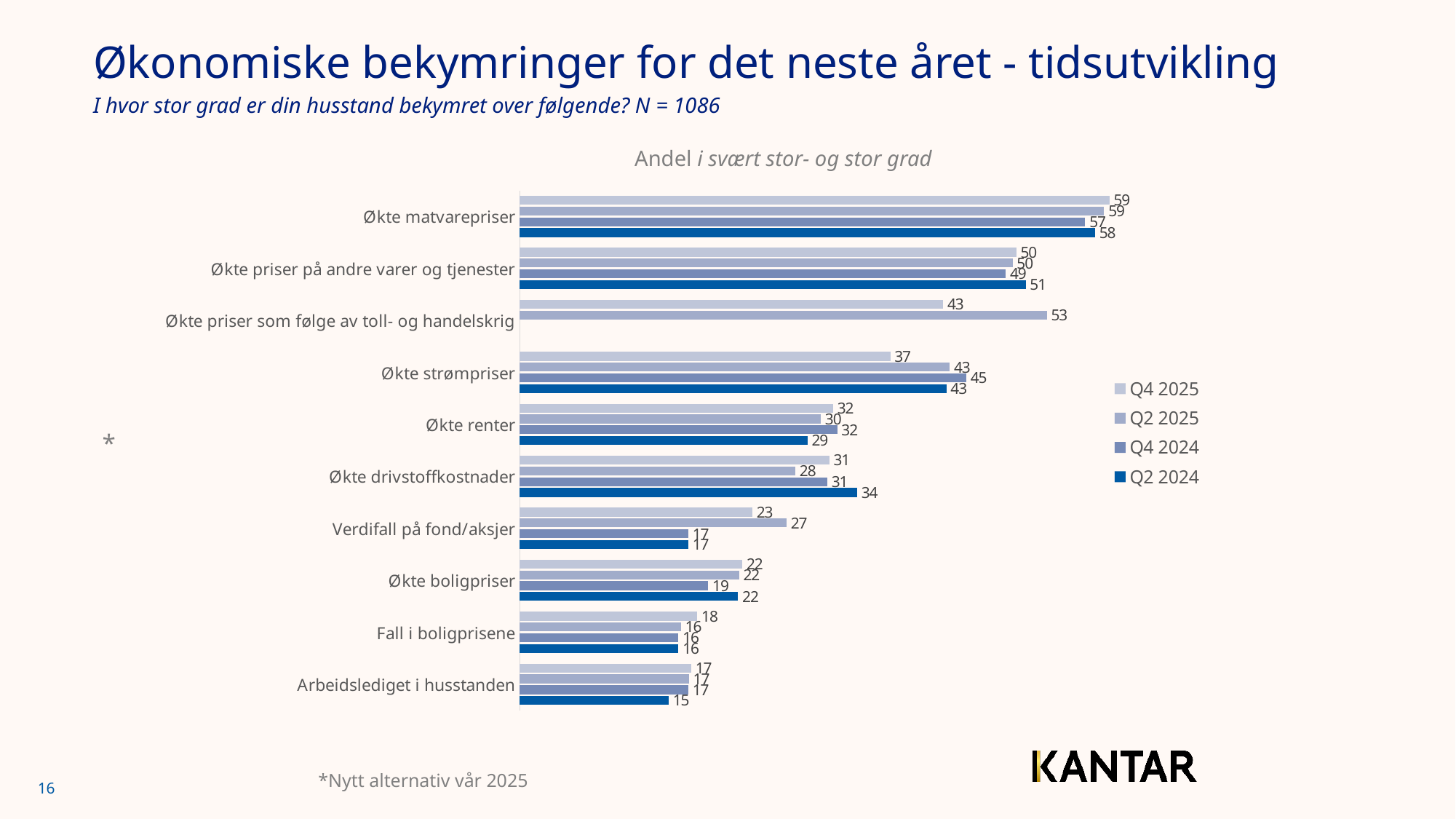
How many series does the legend list? 4 What is the difference between the Q2 2025 and Q4 2024 values for Verdifall på fond/aksjer? 10 Which category has the highest Q4 2025 value? Økte matvarepriser What is the Q4 2025 value for Økte strømpriser? 37 Which series is shown in the darkest blue in the legend? Q2 2024 For Økte renter, which is larger: the Q4 2025 value or the Q2 2024 value? Q4 2025 What kind of chart is shown on the slide? bar chart What is the Q2 2025 value for Økte priser som følge av toll- og handelskrig? 53 What is the Q2 2024 value for Økte drivstoffkostnader? 34 Which category has the lowest Q2 2024 value? Arbeidslediget i husstanden What is the difference between the Q4 2025 and Q2 2025 values for Økte priser som følge av toll- og handelskrig? 10 How many categories are shown on the chart? 10